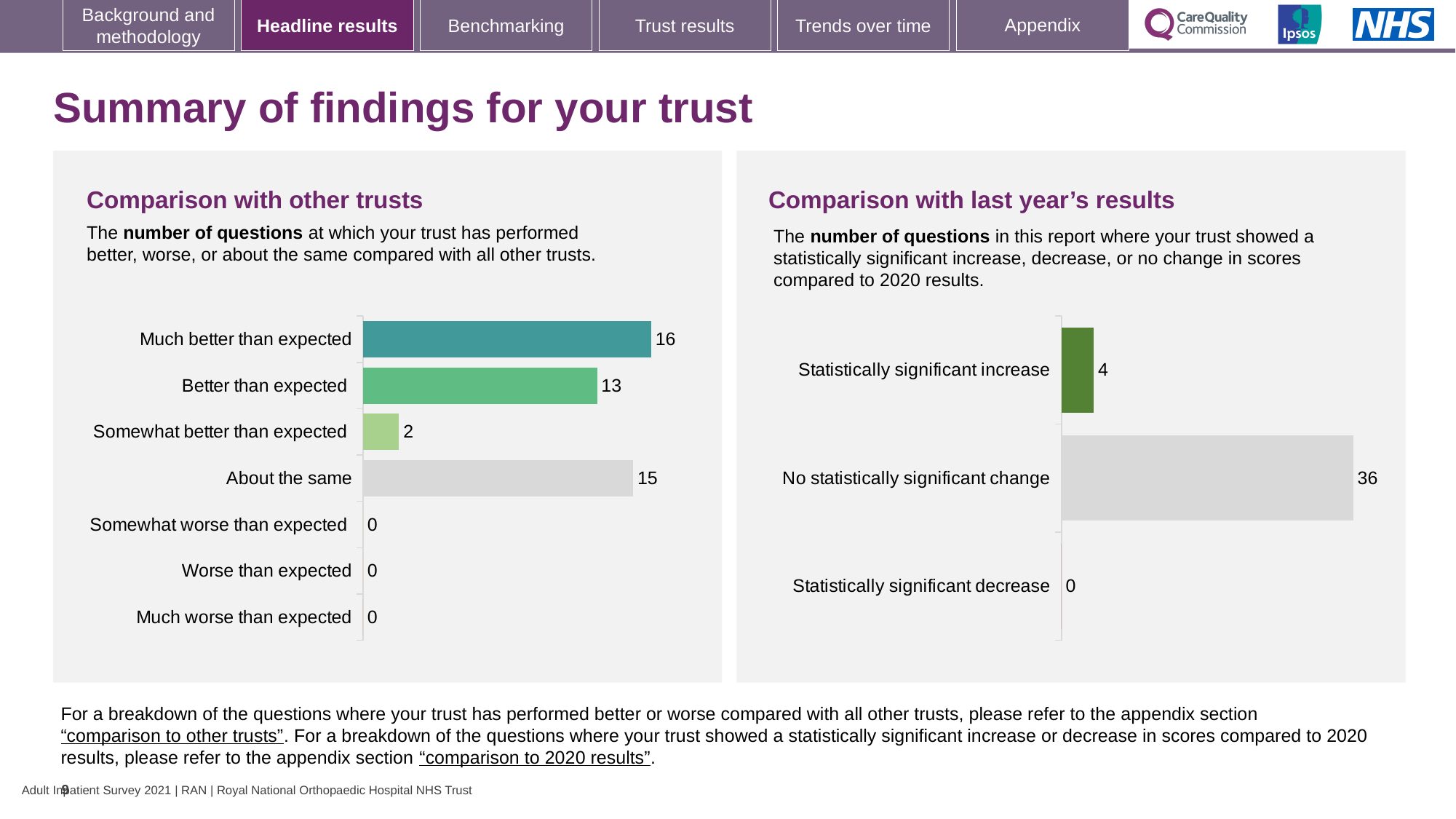
In the 'Comparison with other trusts' chart, what is the value for 'Worse than expected'? 0 How many categories are shown in the 'Comparison with last year's results' chart? 3 In the 'Comparison with last year's results' chart, what is the value for 'Statistically significant increase'? 4 In the 'Comparison with other trusts' chart, which category has the highest value? Much better than expected In the 'Comparison with other trusts' chart, what is the value for 'Much better than expected'? 16 What type of chart is the 'Comparison with last year's results' chart? Bar chart In the 'Comparison with other trusts' chart, what is the value for 'About the same'? 15 How many categories are shown in the 'Comparison with other trusts' chart? 7 In the 'Comparison with other trusts' chart, which is larger: 'Better than expected' or 'Somewhat better than expected'? Better than expected In the 'Comparison with last year's results' chart, what is the difference between 'No statistically significant change' and 'Statistically significant increase'? 32 In the 'Comparison with other trusts' chart, what is the difference between 'Much better than expected' and 'Better than expected'? 3 In the 'Comparison with last year's results' chart, what is the value for 'No statistically significant change'? 36